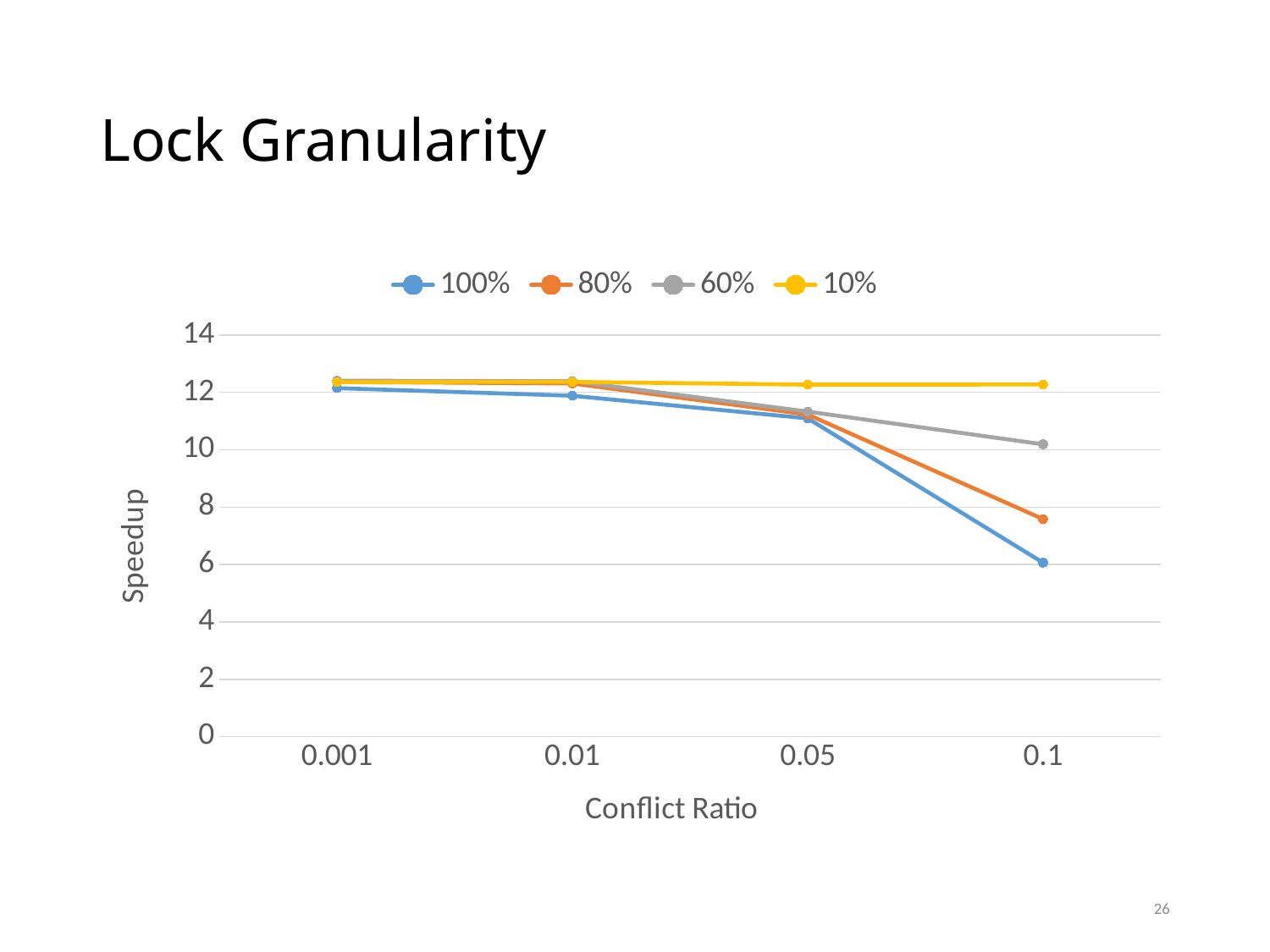
At conflict ratio 0.1, which has the larger speedup, the 100% series or the 60% series? 60% Is the speedup for the 80% series at conflict ratio 0.1 greater or less than 8? less What kind of chart is shown on the slide? line chart What is the label on the y axis? Speedup Is the speedup for the 60% series at conflict ratio 0.1 greater or less than 8? greater How many conflict ratio values are plotted along the x axis? 4 At conflict ratio 0.1, which series has the highest speedup? 10% Does the speedup for the 100% series rise or fall as the conflict ratio increases? falls At conflict ratio 0.1, which series has the lowest speedup? 100% Is the speedup for the 100% series at conflict ratio 0.1 greater or less than 8? less How many series does the legend list? 4